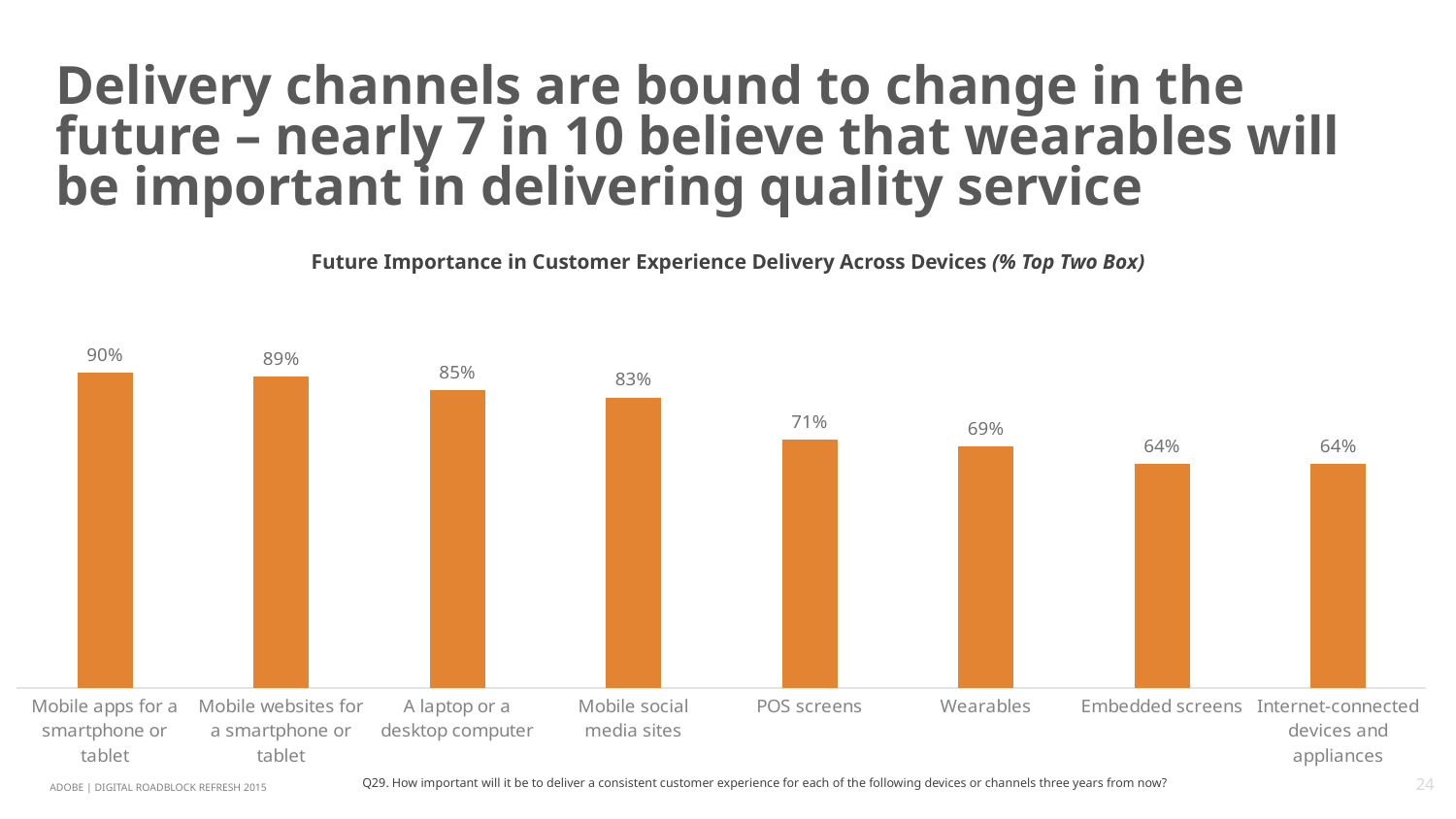
What is the difference between the values for A laptop or a desktop computer and POS screens? 14% What is the value for Wearables? 69% What is the value for Mobile social media sites? 83% What kind of chart is shown on the slide? Bar chart What is the value for POS screens? 71% How many categories are shown in the chart? 8 Which category has the highest value? Mobile apps for a smartphone or tablet What is the difference between the values for Mobile apps for a smartphone or tablet and Wearables? 21% What is the title of the chart? Future Importance in Customer Experience Delivery Across Devices (% Top Two Box) Which is larger, the value for Mobile social media sites or the value for Embedded screens? Mobile social media sites Do the values rise or fall from left to right across the categories? Fall What is the value for Internet-connected devices and appliances? 64%